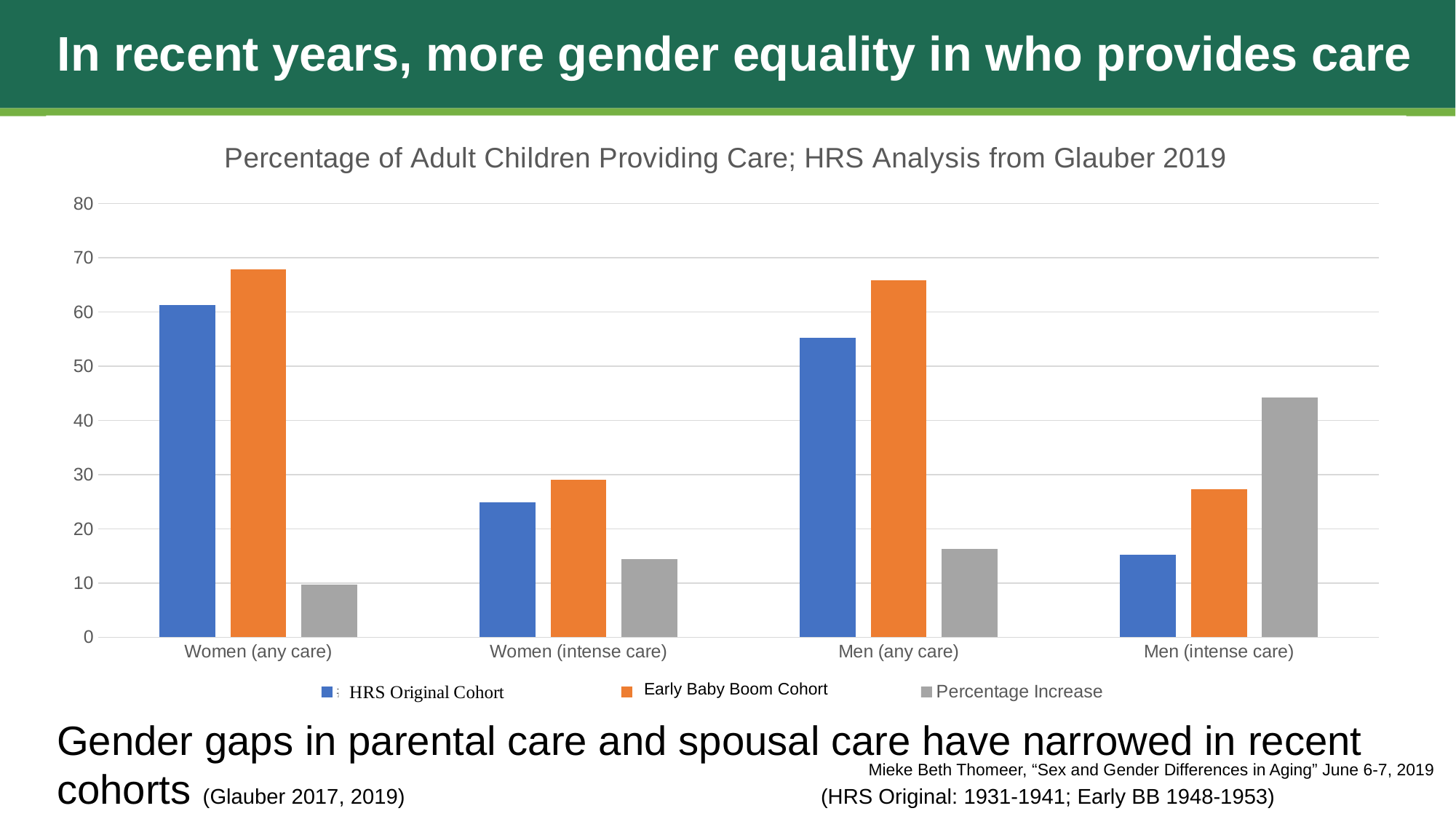
Which is larger: the HRS Original Cohort value for Women (any care) or for Men (any care)? Women (any care) How many categories are shown on the x axis of the chart? 4 Is the Percentage Increase value for Men (intense care) greater or less than 40? greater What colour represents the Percentage Increase series in the chart? gray Which category has the highest Percentage Increase value? Men (intense care) What kind of chart is shown on the slide? bar chart How many series does the chart's legend list? 3 Which category has the lowest HRS Original Cohort value? Men (intense care) Is the Early Baby Boom Cohort value for Men (intense care) greater or less than 20? greater Is the HRS Original Cohort value for Women (any care) greater or less than 50? greater For Men (intense care), which series has the larger value: HRS Original Cohort or Early Baby Boom Cohort? Early Baby Boom Cohort